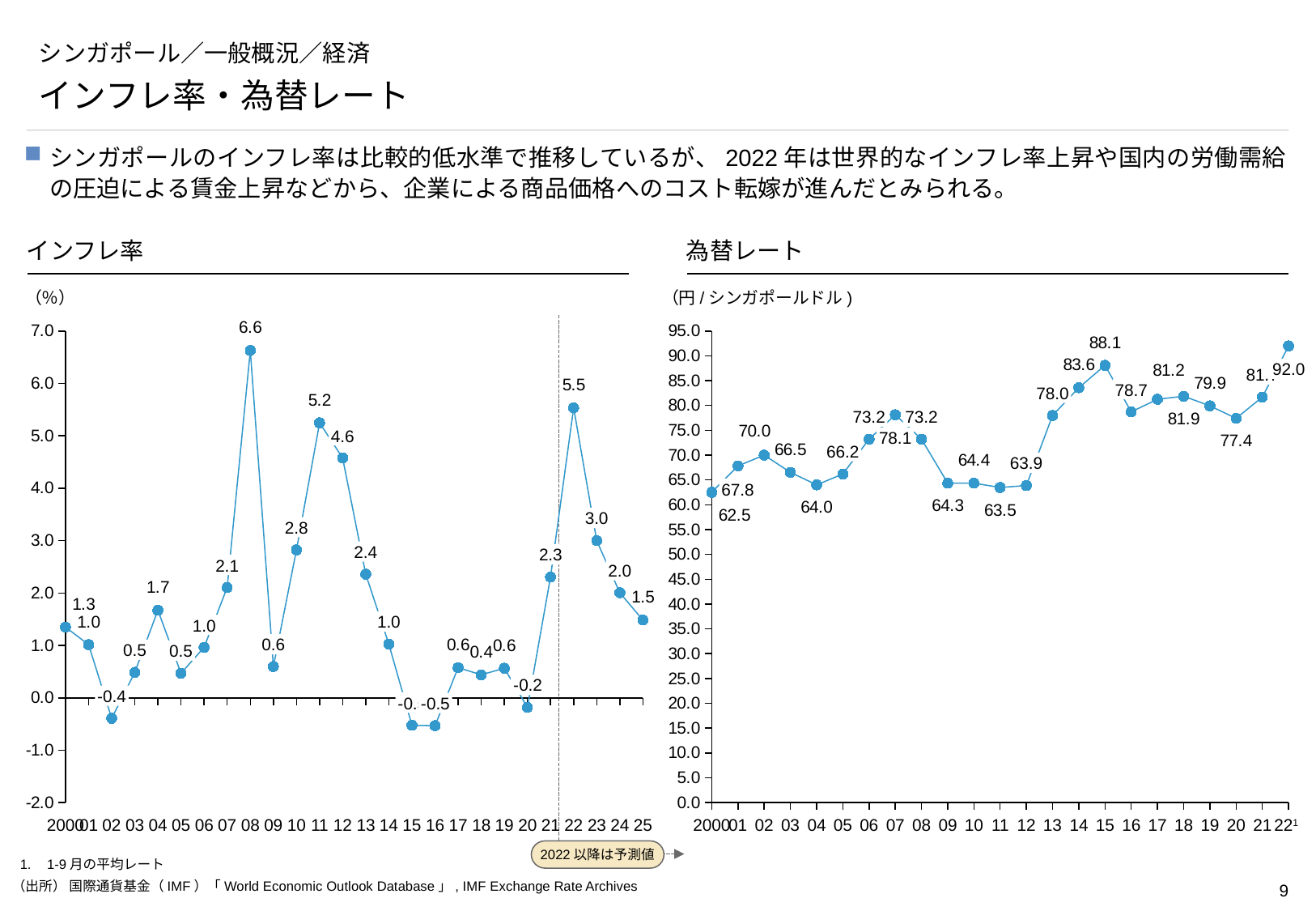
In the インフレ率 chart, do the values rise or fall from 2022 to 2025? fall What unit is shown for the 為替レート chart? 円/シンガポールドル In the インフレ率 chart, what is the value for 2022? 5.5 In the インフレ率 chart, what is the inflation rate for 2008? 6.6 In the 為替レート chart, what is the difference between the values for 2015 and 2016? 9.4 In the 為替レート chart, which year has the lowest value? 2000 In the 為替レート chart, what is the value for 2015? 88.1 In the インフレ率 chart, what is the difference between the values for 2022 and 2023? 2.5 In the インフレ率 chart, which year has the highest inflation rate? 2008 In the 為替レート chart, which year has the highest value? 2022 In the 為替レート chart, which is larger, the value for 2014 or the value for 2017? 2014 What kind of chart is the インフレ率 chart on the left? line chart